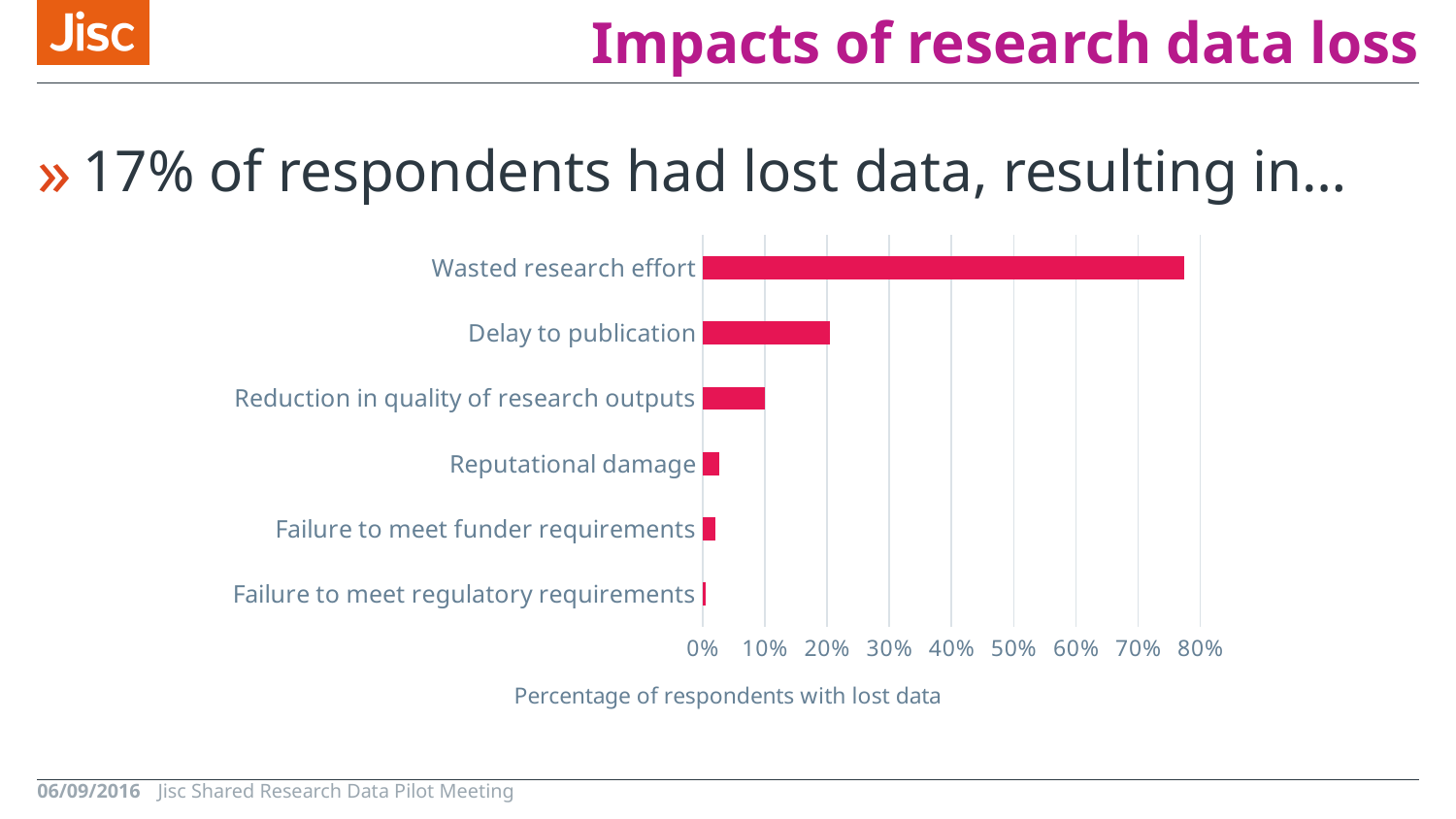
What kind of chart is shown on the slide? bar chart Is the value for Wasted research effort greater or less than 80%? less Is the value for Reputational damage greater or less than 10%? less Is the value for Wasted research effort greater or less than 70%? greater Which is larger, the value for Delay to publication or the value for Reduction in quality of research outputs? Delay to publication Which category has the lowest value in the chart? Failure to meet regulatory requirements How many categories are plotted in the chart? 6 What is the highest value shown on the horizontal axis of the chart? 80% Which category has the highest value in the chart? Wasted research effort Which is larger, the value for Reputational damage or the value for Wasted research effort? Wasted research effort What is the label on the horizontal axis of the chart? Percentage of respondents with lost data